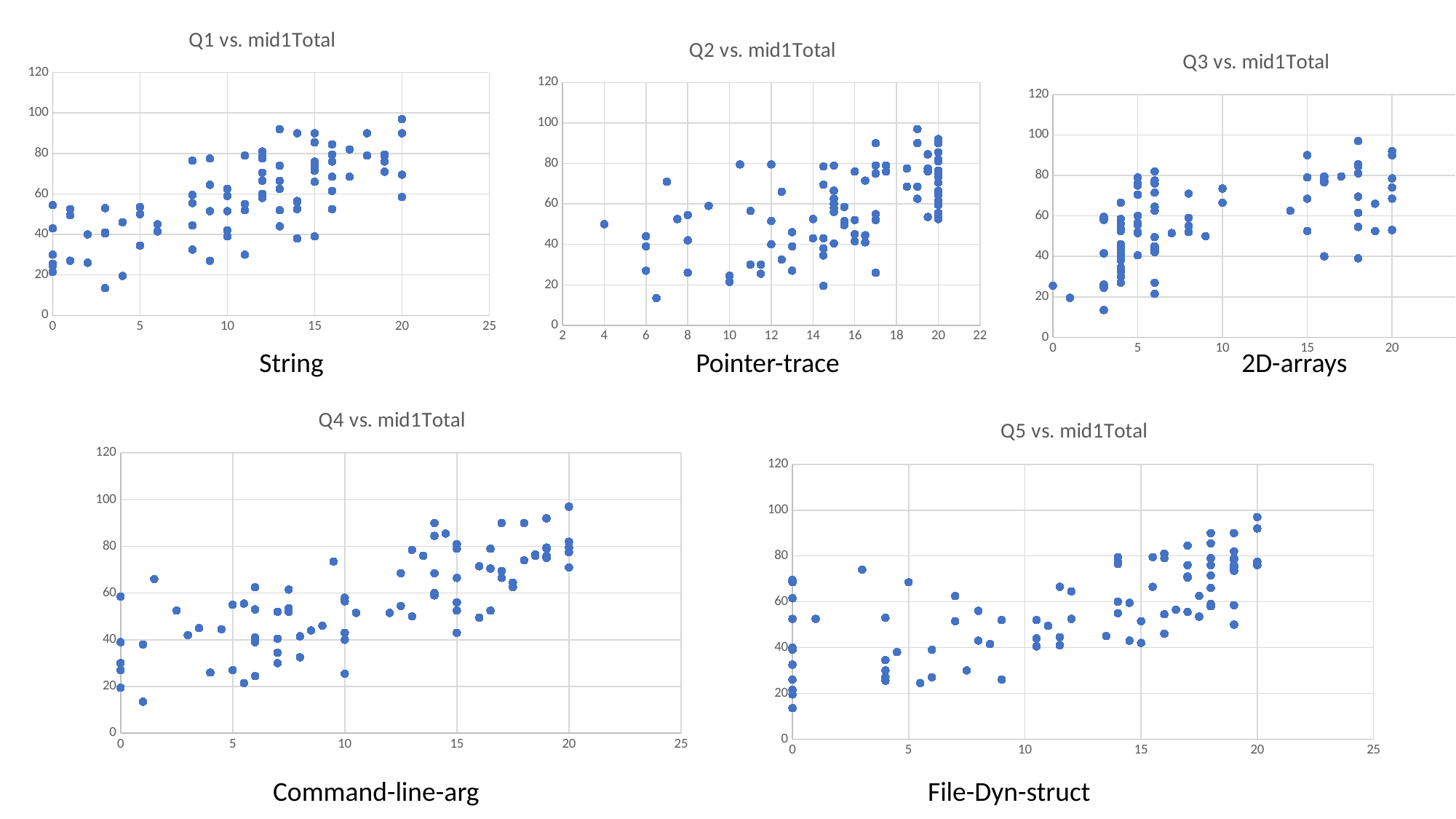
How many charts are shown on the slide? 5 In the 'Q2 vs. mid1Total' chart, is the value of the point at x = 4 greater or less than 80? less What caption appears below the 'Q3 vs. mid1Total' chart? 2D-arrays What kind of chart is the 'Q1 vs. mid1Total' chart? scatter chart In the 'Q5 vs. mid1Total' chart, do the values generally rise or fall along the x axis? rise In the 'Q3 vs. mid1Total' chart, is the value of the point at x = 1 greater or less than 40? less In the 'Q1 vs. mid1Total' chart, do the mid1Total values generally rise or fall as Q1 increases along the x axis? rise In the 'Q1 vs. mid1Total' chart, is the highest plotted value greater or less than 80? greater In the 'Q4 vs. mid1Total' chart, do the values generally rise or fall along the x axis? rise What caption appears below the 'Q4 vs. mid1Total' chart? Command-line-arg